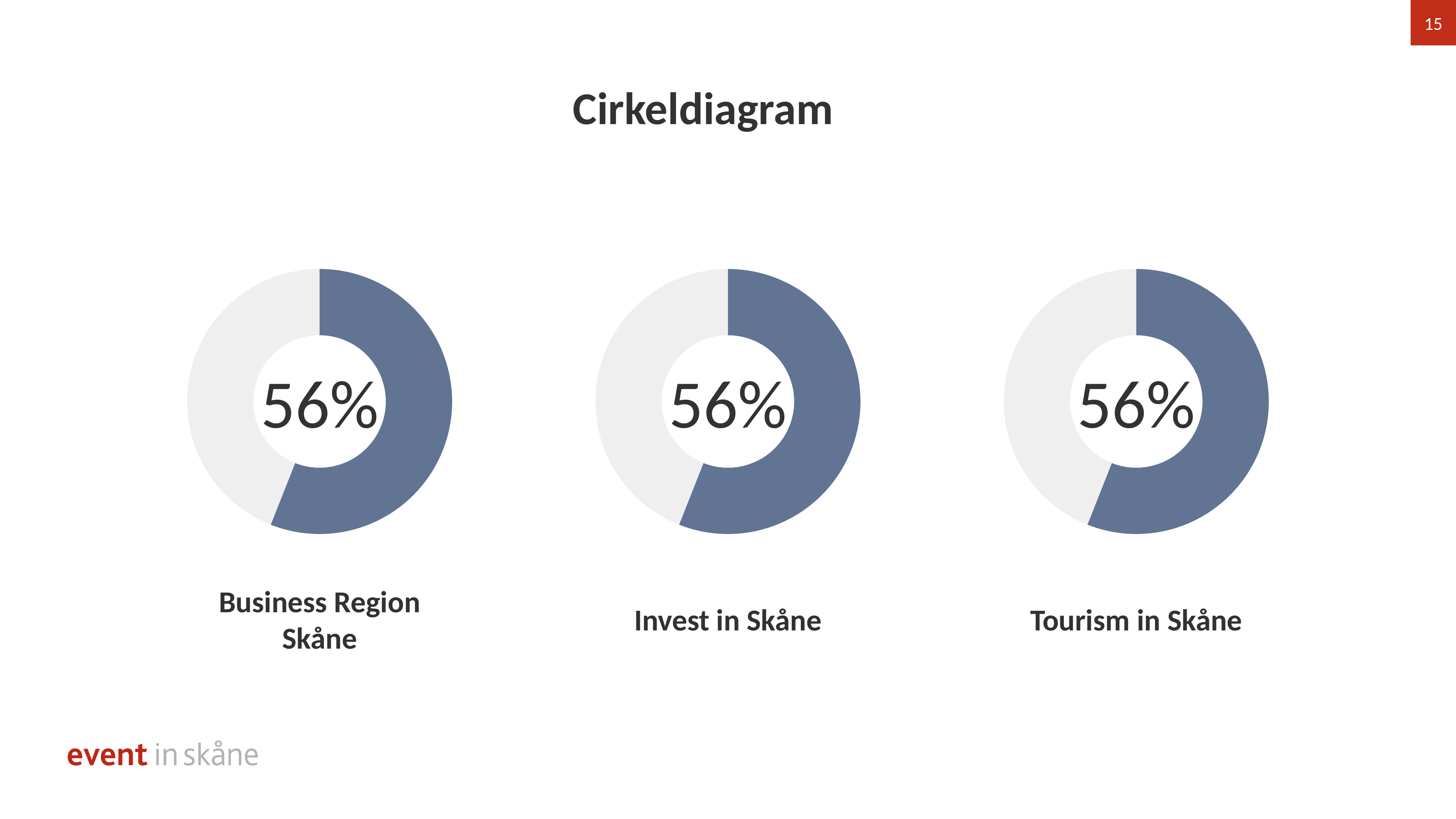
In the Tourism in Skåne chart, is the value shown greater or less than 50%? greater What value is shown in the Business Region Skåne chart? 56% Which chart is positioned in the middle of the slide? Invest in Skåne What colour is the filled 56% portion of the Invest in Skåne chart? Blue What kind of chart is used for Business Region Skåne? Donut (pie) chart What is the title of the slide? Cirkeldiagram What value is shown in the Tourism in Skåne chart? 56% How many charts are shown on the slide? 3 What value is shown in the Invest in Skåne chart? 56%